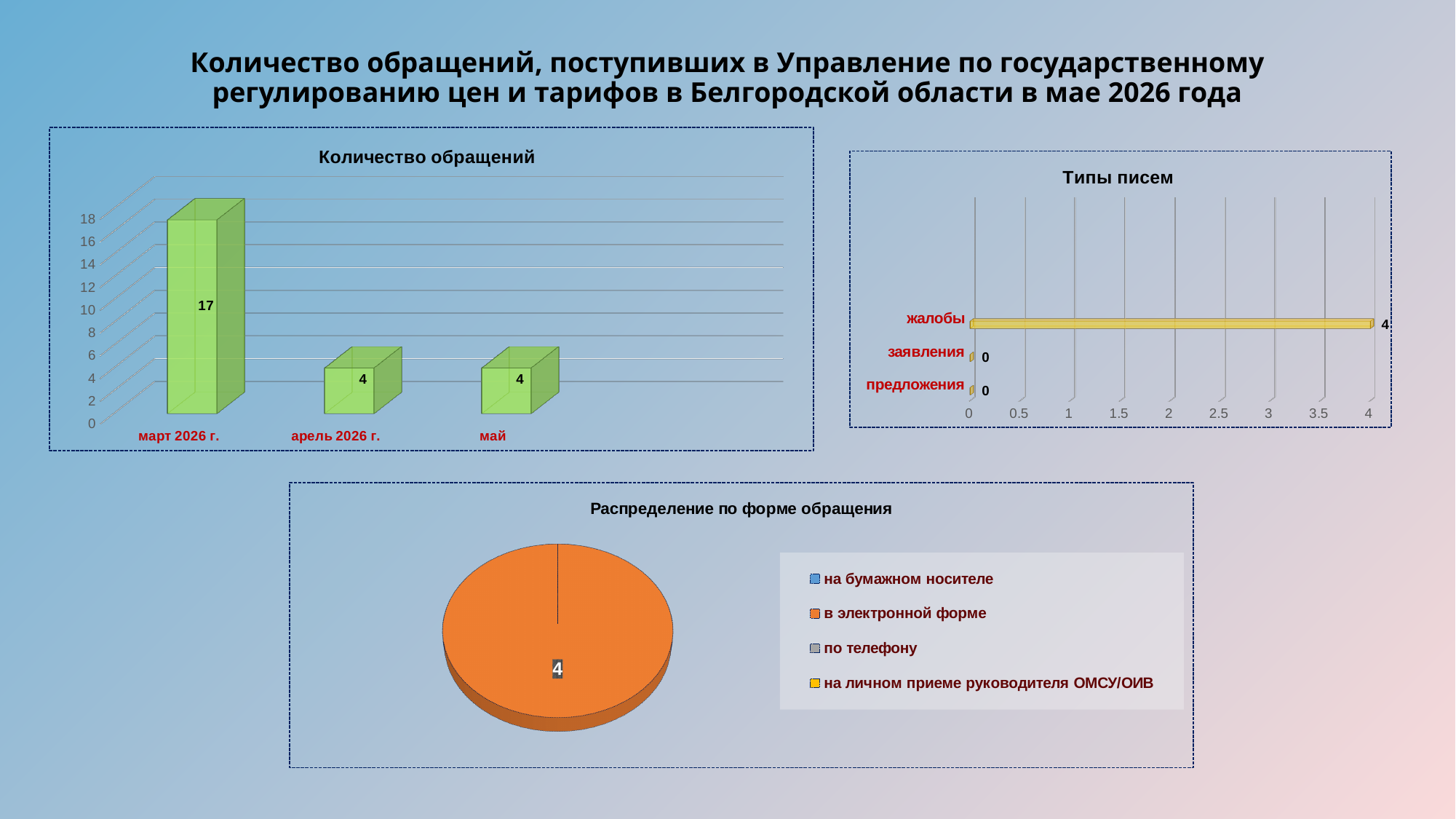
In the 'Количество обращений' chart, what is the value for май? 4 In the 'Количество обращений' chart, which category has the highest value? март 2026 г. In the 'Распределение по форме обращения' chart, which legend entry does the orange slice correspond to? в электронной форме What kind of chart is 'Типы писем'? bar chart In the 'Количество обращений' chart, what is the difference between the values for март 2026 г. and арель 2026 г.? 13 In the 'Типы писем' chart, what is the value for заявления? 0 In the 'Типы писем' chart, which category has the highest value? жалобы In the 'Количество обращений' chart, how many categories are shown on the x axis? 3 In the 'Типы писем' chart, what is the value for жалобы? 4 In the 'Количество обращений' chart, do the values rise or fall from март 2026 г. to май? fall In the 'Количество обращений' chart, what is the value for март 2026 г.? 17 In the 'Распределение по форме обращения' chart, how many entries does the legend list? 4